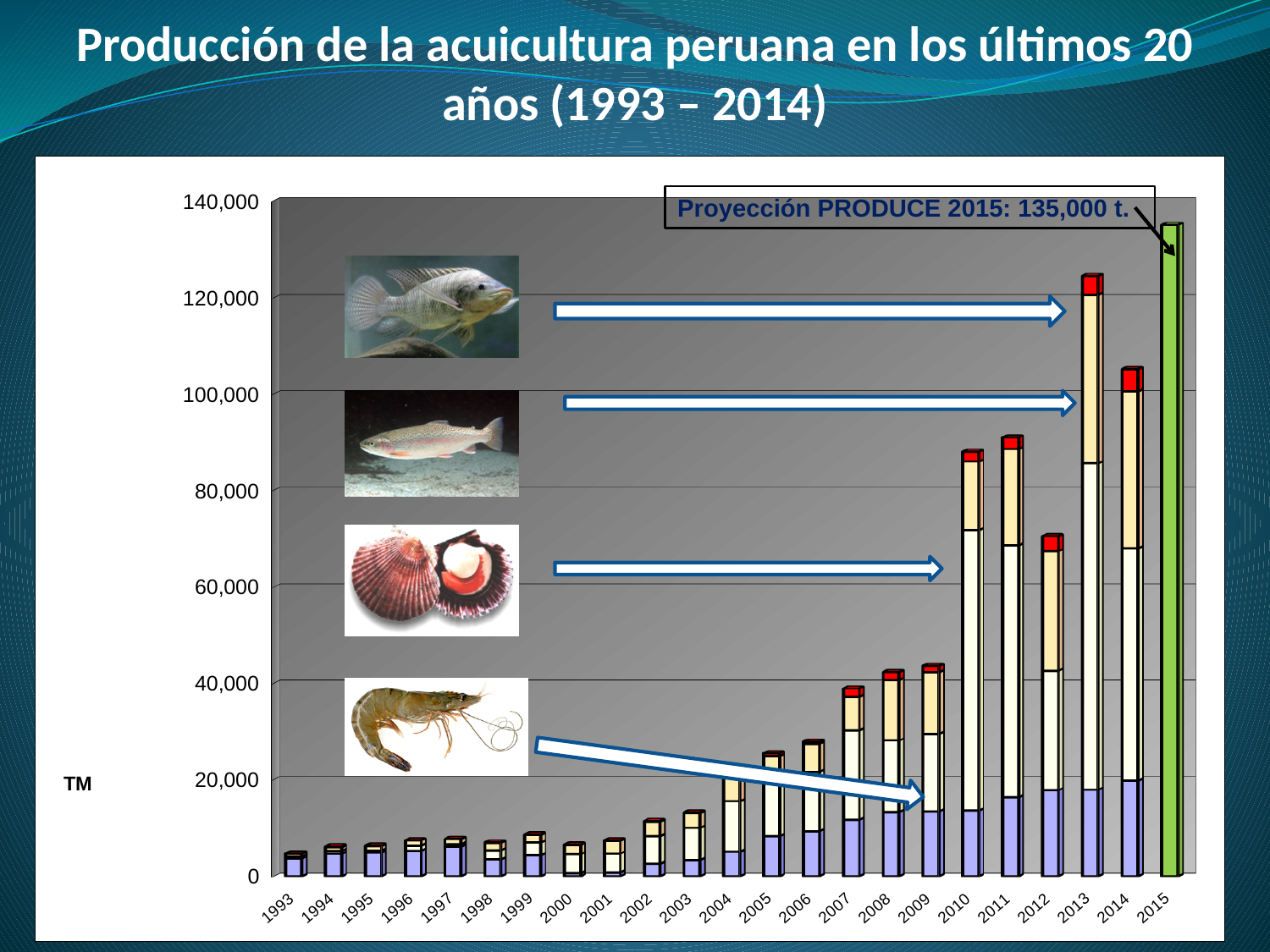
Which year has the tallest bar in the chart? 2015 Is the value for 2013 greater or less than 120,000? greater What is the PRODUCE projection for 2015 shown in the text box? 135,000 t. Is the value for 2010 greater or less than 80,000? greater Which year has the larger total production, 2013 or 2014? 2013 Overall, does production rise or fall from 1993 to 2015? Rise Which year has the larger total production, 2011 or 2012? 2011 Is the value for 2003 greater or less than 20,000? less How many years (bars) are plotted along the x axis? 23 Excluding the 2015 projection, which year has the highest production? 2013 What kind of chart is shown on the slide? Stacked bar chart